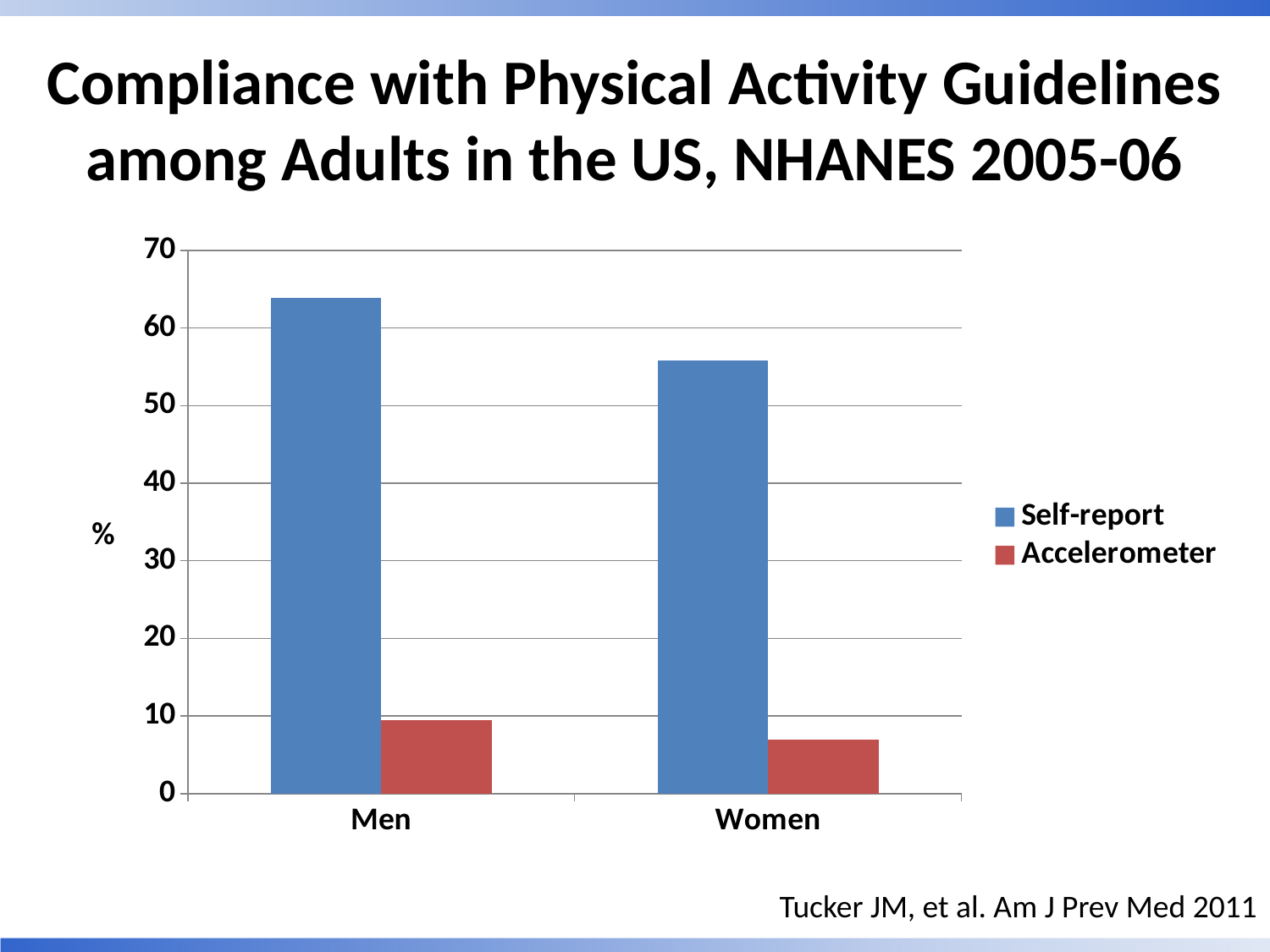
Which bar is the lowest in the chart? Accelerometer for Women Is the Accelerometer value for Men greater or less than 20? less Which category has the higher Self-report value, Men or Women? Men Which series is shown in blue? Self-report Is the Self-report value for Men greater or less than 60? greater Is the Accelerometer value for Women greater or less than 10? less What kind of chart is shown on the slide? bar chart What is the label on the y axis? % How many series does the legend list? 2 For Men, which series has the larger value, Self-report or Accelerometer? Self-report How many categories are shown on the x axis? 2